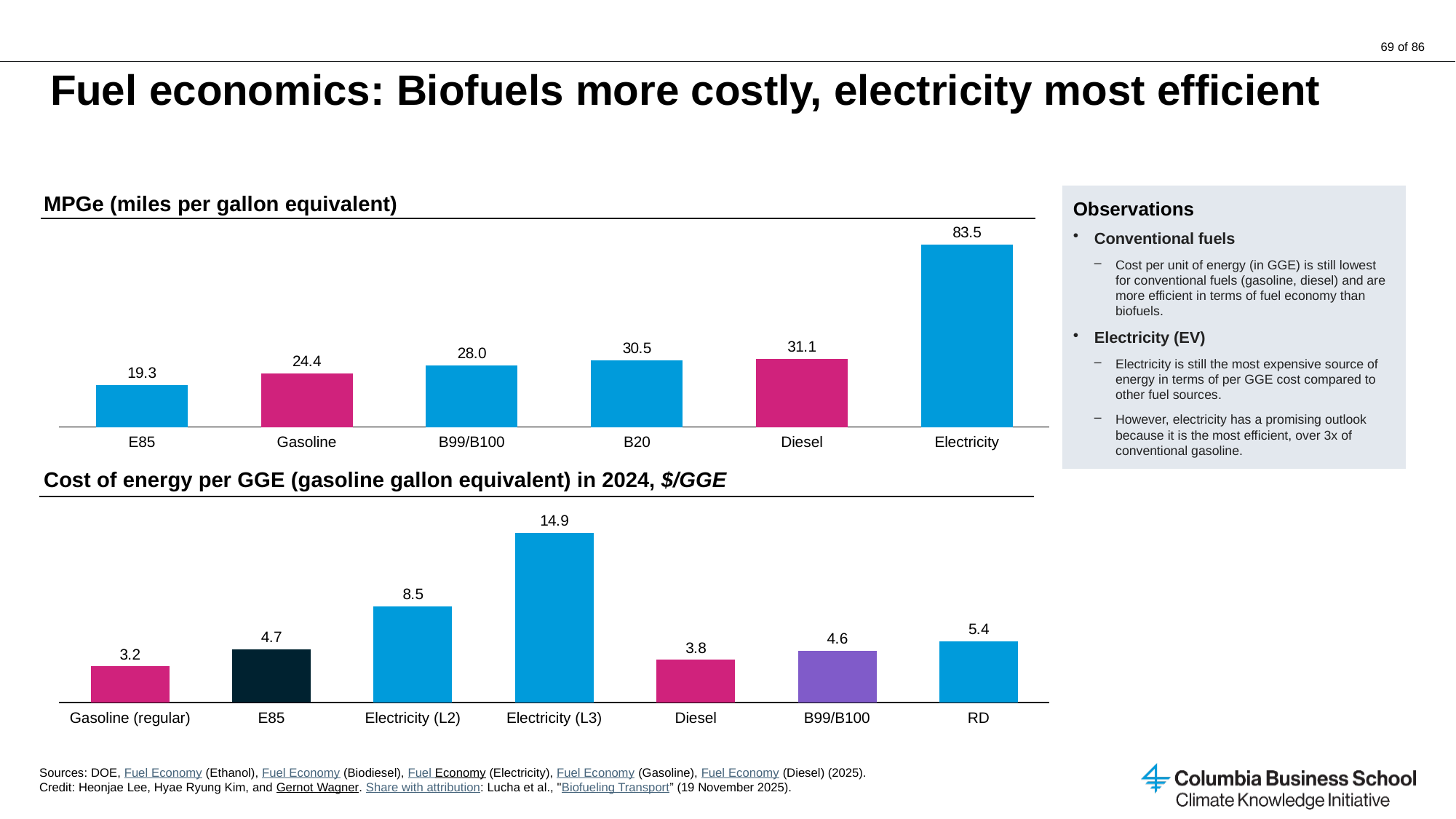
In the MPGe (miles per gallon equivalent) chart, how many categories are shown? 6 In the MPGe (miles per gallon equivalent) chart, what is the difference between Diesel and Gasoline? 6.7 In the Cost of energy per GGE chart, which category has the highest value? Electricity (L3) In the Cost of energy per GGE chart, what is the value for Electricity (L3)? 14.9 In the MPGe (miles per gallon equivalent) chart, which category has the lowest value? E85 In the MPGe (miles per gallon equivalent) chart, what is the value for Electricity? 83.5 In the Cost of energy per GGE chart, how many categories are shown? 7 What type of chart is the Cost of energy per GGE chart? Bar chart In the Cost of energy per GGE chart, what is the difference between Electricity (L3) and Electricity (L2)? 6.4 In the MPGe (miles per gallon equivalent) chart, which is larger, B20 or B99/B100? B20 In the Cost of energy per GGE chart, what is the value for RD? 5.4 In the Cost of energy per GGE chart, which category has the lowest value? Gasoline (regular)